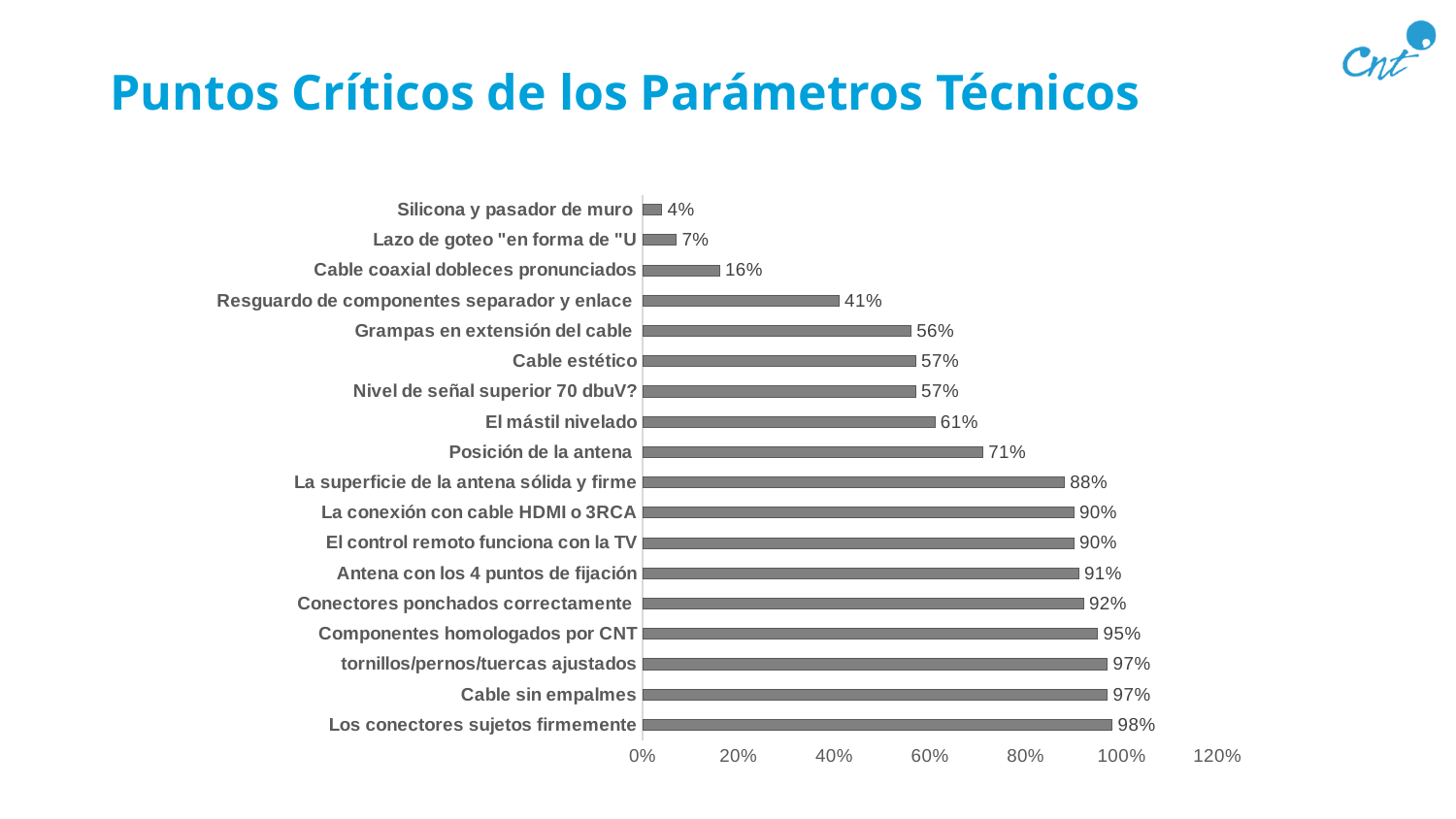
What is the difference between the values for "La superficie de la antena sólida y firme" and "Posición de la antena"? 17% What is the title of the slide? Puntos Críticos de los Parámetros Técnicos Which category has the highest value? Los conectores sujetos firmemente What is the value for "Resguardo de componentes separador y enlace"? 41% How many categories are shown in the chart? 18 Which is larger, the value for "El mástil nivelado" or the value for "Cable coaxial dobleces pronunciados"? El mástil nivelado What is the value for "Silicona y pasador de muro"? 4% Is the value for "Componentes homologados por CNT" greater or less than 80%? greater What is the difference between the values for "Los conectores sujetos firmemente" and "Silicona y pasador de muro"? 94% Which category has the lowest value? Silicona y pasador de muro What kind of chart is shown on the slide? Bar chart What is the value for "Posición de la antena"? 71%